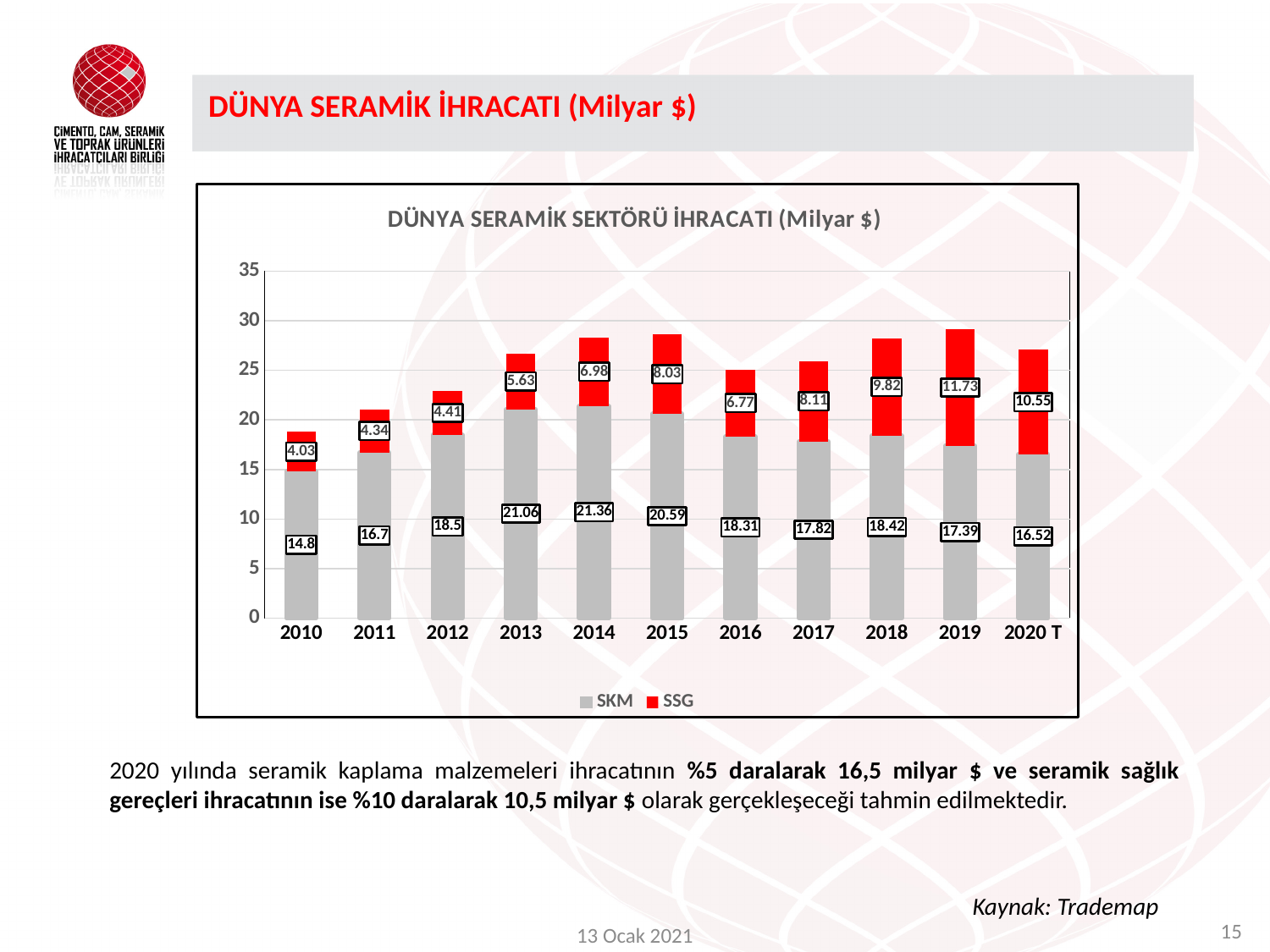
What kind of chart is shown? Stacked bar chart Which year has the lowest SKM value? 2010 What is the difference between the SSG values for 2019 and 2018? 1.91 Which year has the highest SSG value? 2019 How many years are shown on the x axis? 11 What is the SKM value for 2014? 21.36 Which series is shown in red in the legend? SSG What is the SSG value for 2019? 11.73 What is the total of the stacked bar for 2010? 18.83 Which is larger, the SKM value for 2013 or the SKM value for 2016? 2013 What is the SKM value for 2020 T? 16.52 How many series does the legend list? 2